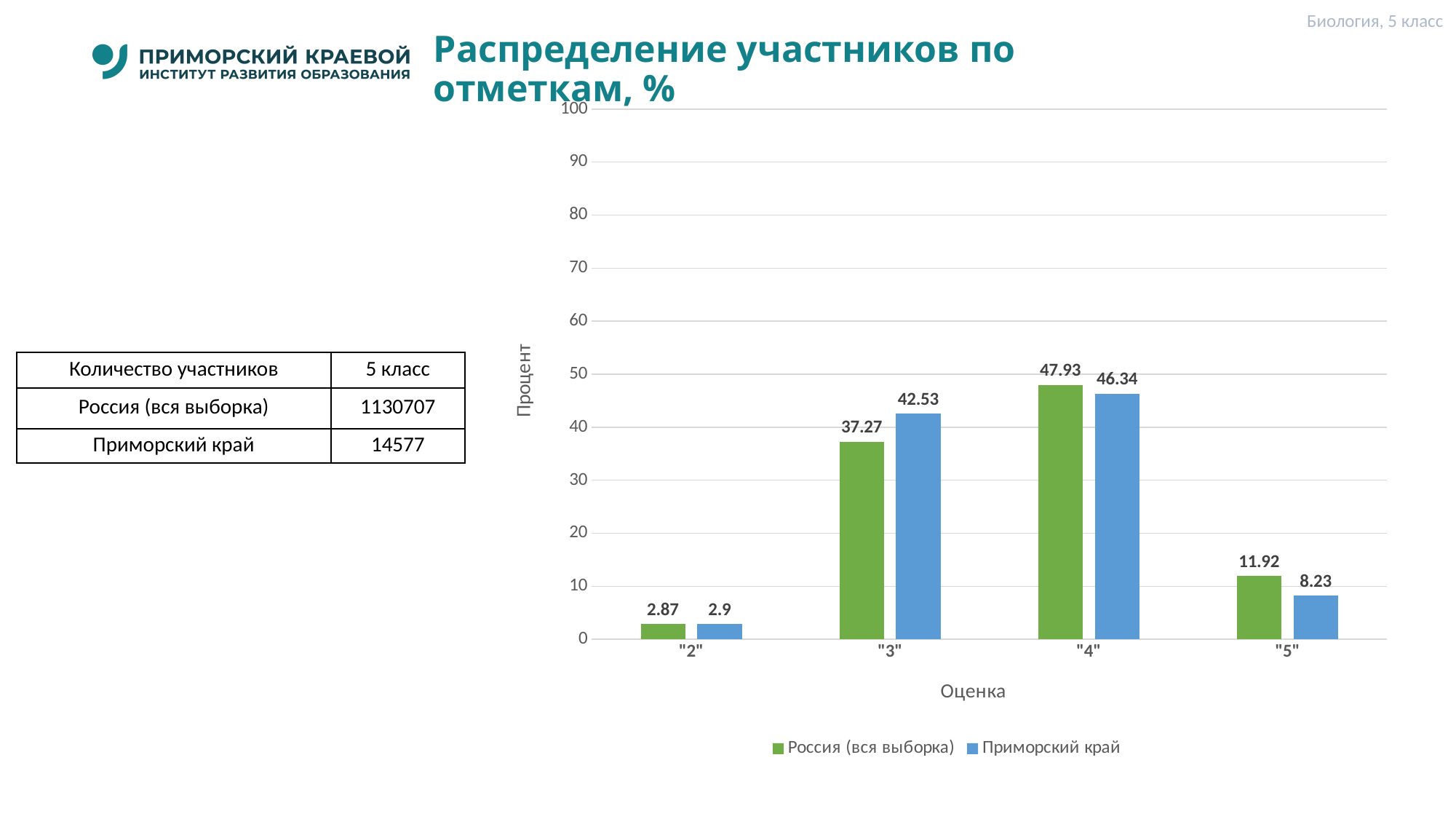
What is the label of the y axis? Процент What is the value for Приморский край at grade "5"? 8.23 At grade "3", which series has the larger value: Россия (вся выборка) or Приморский край? Приморский край What kind of chart is shown on the slide? bar chart What is the difference between Россия (вся выборка) and Приморский край at grade "4"? 1.59 How many grade categories are shown on the x axis? 4 What is the value for Россия (вся выборка) at grade "3"? 37.27 Is the value for Россия (вся выборка) at grade "5" greater or less than 20? less What is the value for Приморский край at grade "2"? 2.9 Which grade has the lowest value for Россия (вся выборка)? "2" How many series does the legend list? 2 Which grade has the highest value for Приморский край? "4"